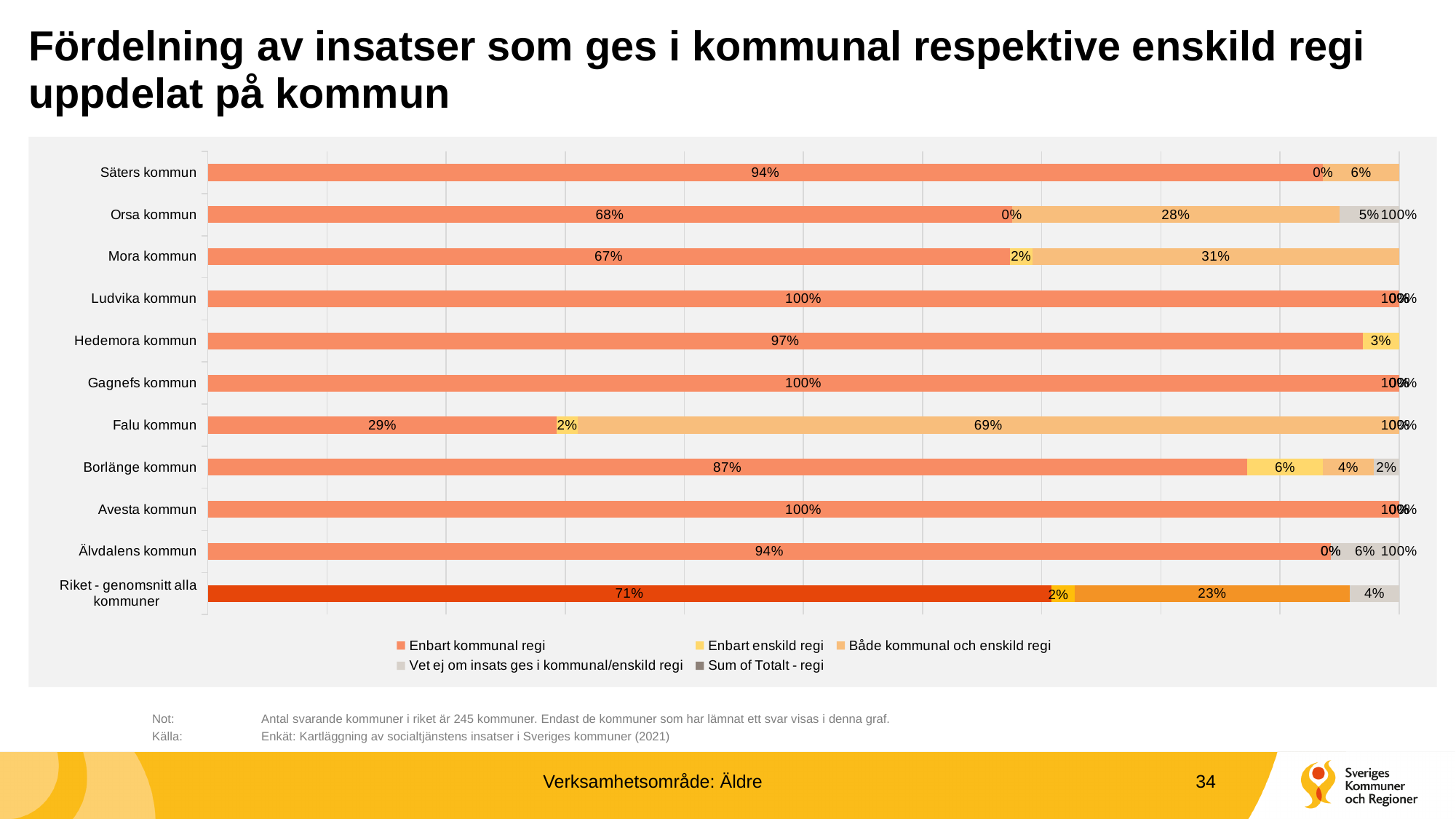
What is the value of Enbart kommunal regi for Riket - genomsnitt alla kommuner? 71% What is the value of Både kommunal och enskild regi for Mora kommun? 31% What is the value of Enbart enskild regi for Borlänge kommun? 6% What is the value of Enbart kommunal regi for Falu kommun? 29% How many categories (rows) are shown on the chart? 11 Which has a larger value for Enbart kommunal regi, Borlänge kommun or Hedemora kommun? Hedemora kommun What kind of chart is shown on the slide? Stacked bar chart How many series does the legend list? 5 Which category has the highest value for Både kommunal och enskild regi? Falu kommun What is the difference in Både kommunal och enskild regi between Falu kommun (69%) and Riket - genomsnitt alla kommuner (23%)? 46 percentage points What is the value of Både kommunal och enskild regi for Riket - genomsnitt alla kommuner? 23% Which municipality has the lowest value for Enbart kommunal regi? Falu kommun